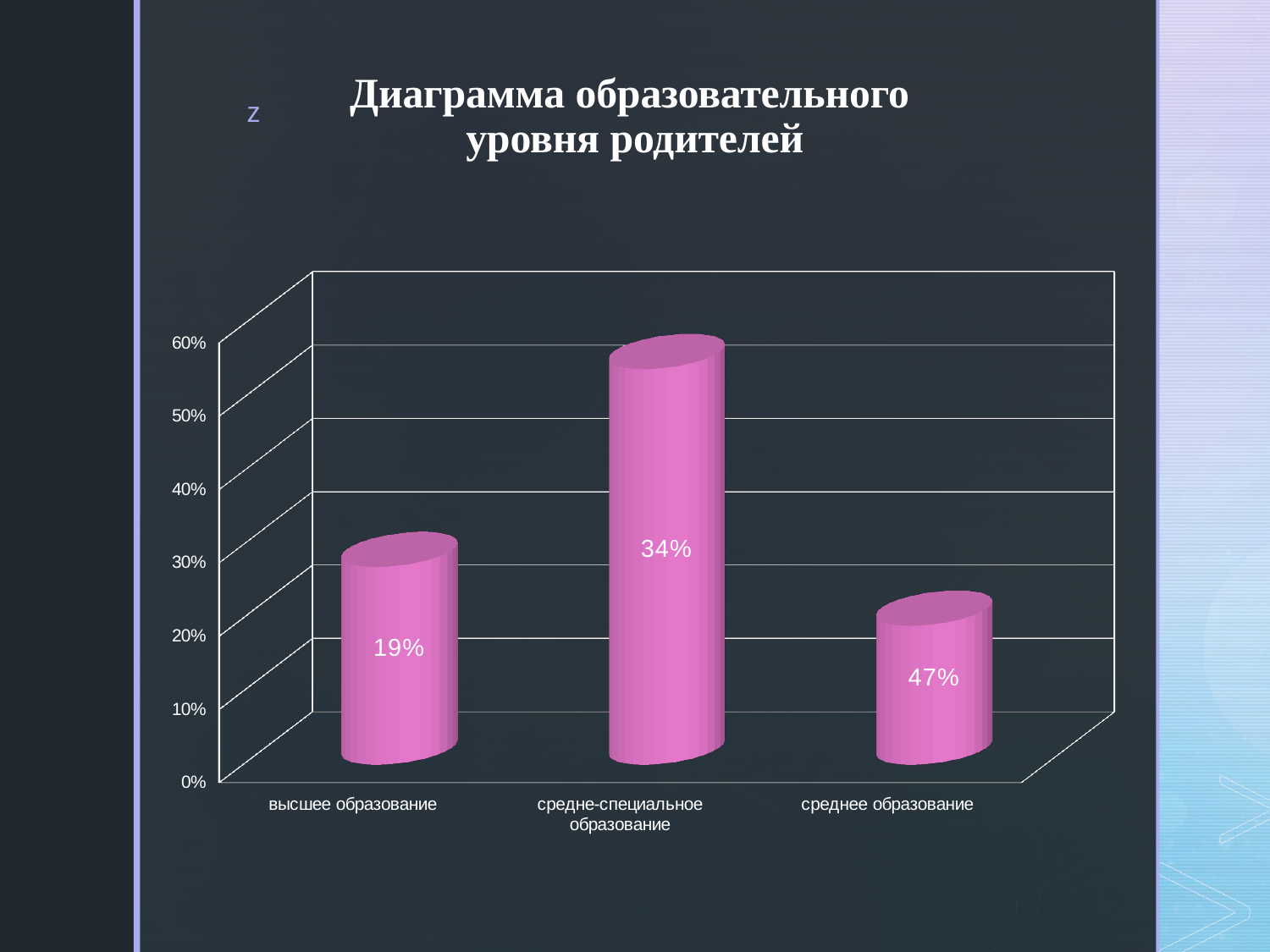
What is the difference between the labelled values for среднее образование and высшее образование? 28% What is the value shown for средне-специальное образование? 34% What kind of chart is shown on the slide? bar chart What colour are the bars in the chart? pink What is the highest tick value shown on the vertical axis? 60% What is the title of the chart on the slide? Диаграмма образовательного уровня родителей How many categories are shown on the x axis of the chart? 3 What is the value shown for среднее образование? 47% What is the value shown for высшее образование? 19% Is the value for средне-специальное образование greater or less than 30%? greater Is the value for высшее образование greater or less than 40%? less